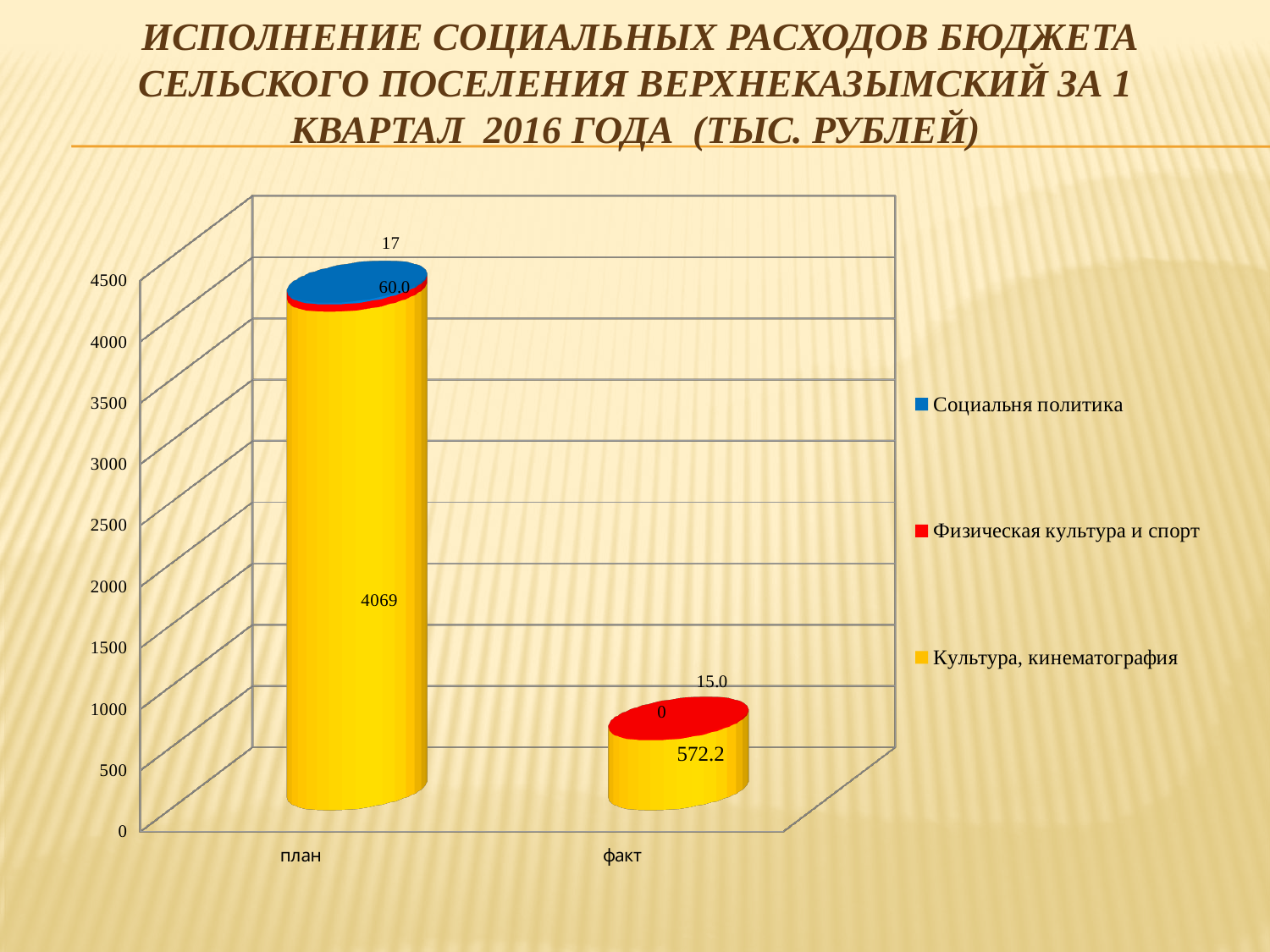
What is the value of Социальня политика for факт? 0 What is the value of Социальня политика for план? 17 How many categories are shown on the x axis? 2 How many series does the legend list? 3 What is the difference between the Культура, кинематография values for план and факт? 3496.8 Which category has the larger Физическая культура и спорт value, план or факт? план What kind of chart is shown on the slide? bar chart What is the value of Культура, кинематография for план? 4069 What is the value of Физическая культура и спорт for факт? 15.0 What is the value of Физическая культура и спорт for план? 60.0 What is the value of Культура, кинематография for факт? 572.2 What is the total of the stacked bar for факт? 587.2